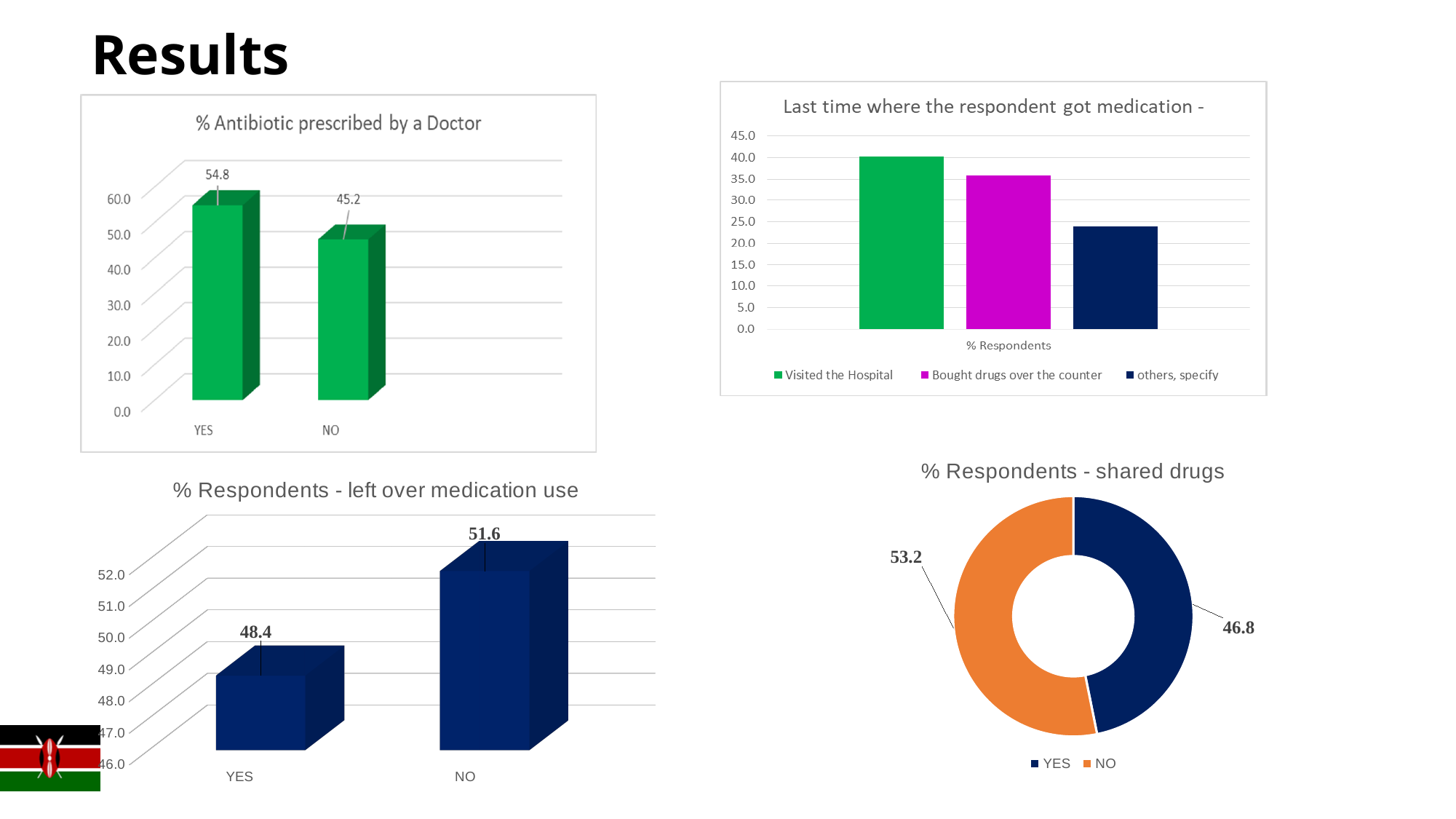
In the '% Respondents - left over medication use' chart, what is the value for NO? 51.6 In the 'Last time where the respondent got medication' chart, is the value for 'Visited the Hospital' greater or less than 35.0? greater In the '% Respondents - shared drugs' chart, what is the value for YES? 46.8 In the '% Antibiotic prescribed by a Doctor' chart, which category has the lower value? NO In the 'Last time where the respondent got medication' chart, is the value for 'others, specify' greater or less than 25.0? less In the 'Last time where the respondent got medication' chart, which series has the highest value? Visited the Hospital In the '% Respondents - shared drugs' chart, which colour represents NO? Orange In the '% Respondents - left over medication use' chart, which is larger, YES or NO? NO In the '% Antibiotic prescribed by a Doctor' chart, what is the value for YES? 54.8 What kind of chart is '% Respondents - shared drugs'? Doughnut (pie) chart How many series does the legend of the 'Last time where the respondent got medication' chart list? 3 In the '% Antibiotic prescribed by a Doctor' chart, what is the difference between the YES and NO values? 9.6